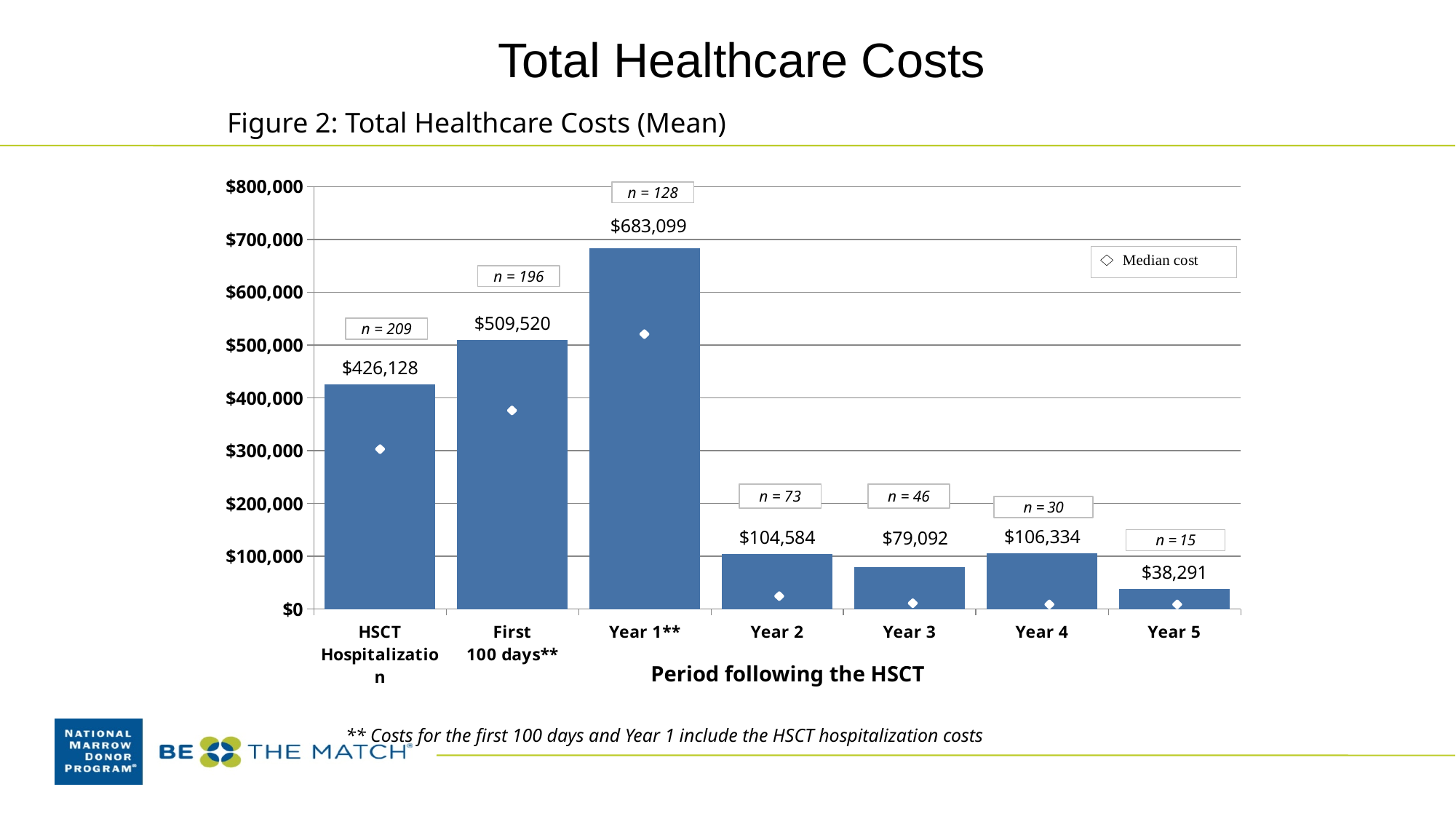
Is the median cost for the First 100 days** greater or less than $400,000? less What is the mean total healthcare cost for Year 5? $38,291 What is the difference between the mean cost for Year 1** and the mean cost for the First 100 days**? $173,579 What is the sample size (n) shown for the First 100 days** period? n = 196 What is the mean total healthcare cost for the HSCT Hospitalization period? $426,128 Which period has the lowest mean total healthcare cost? Year 5 What kind of chart is used to show the mean total healthcare costs? Bar chart How many periods are shown on the x axis of the chart? 7 Which has a larger mean total healthcare cost, Year 2 or Year 3? Year 2 Is the median cost for Year 1** greater or less than $500,000? greater What is the mean total healthcare cost for Year 1**? $683,099 Which period has the highest mean total healthcare cost? Year 1**